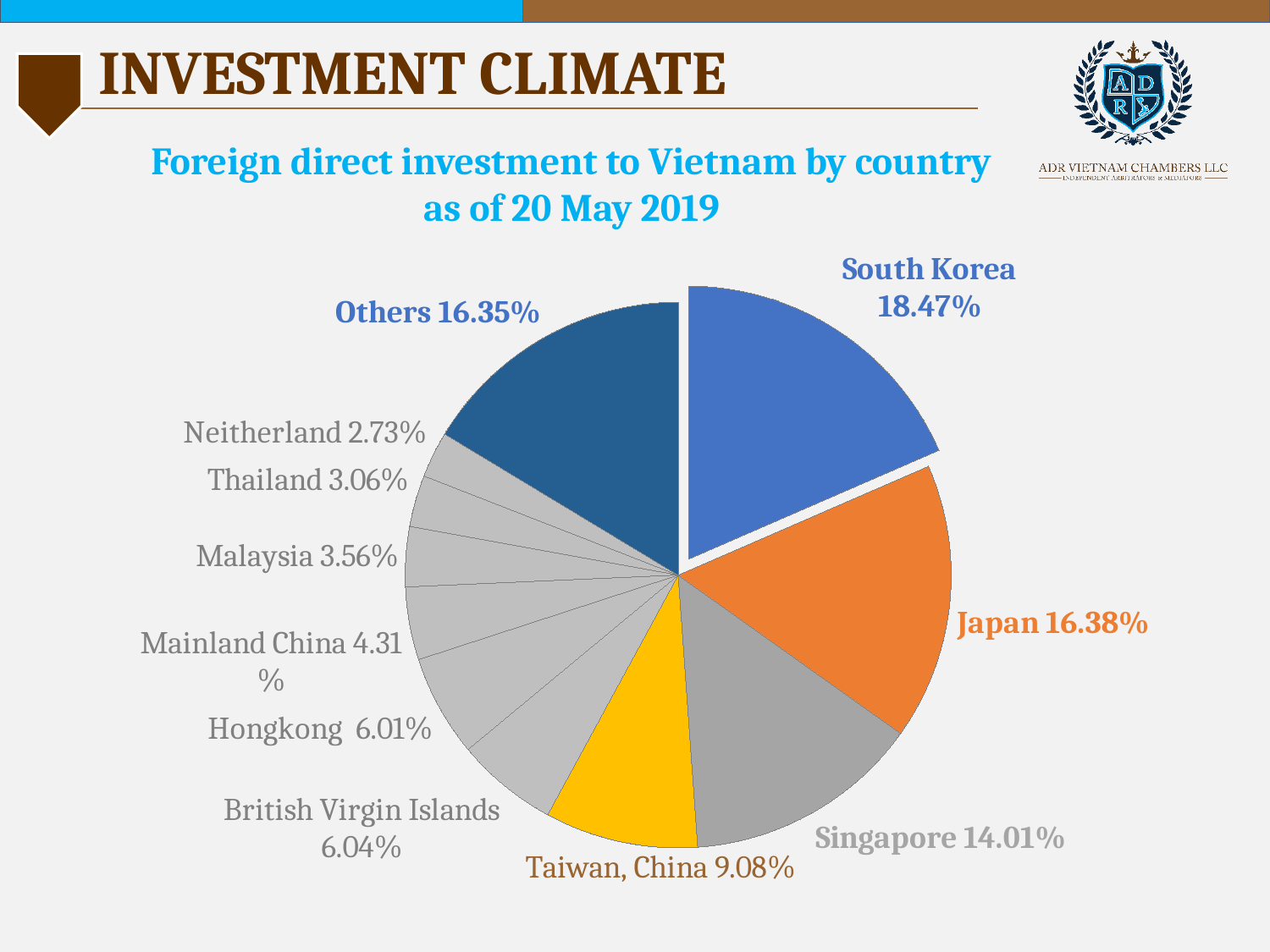
Which named country has the largest share of foreign direct investment to Vietnam? South Korea What percentage is shown for Malaysia? 3.56% What is the difference in percentage points between Singapore and Taiwan, China? 4.93 What share of foreign direct investment to Vietnam does South Korea account for? 18.47% Which slice of the pie chart has the smallest share? Neitherland What type of chart is shown on the slide? Pie chart What percentage is shown for Singapore? 14.01% What is the value shown for Japan in the pie chart? 16.38% How many slices does the pie chart have? 11 How many percentage points larger is South Korea's share than Japan's? 2.09 What share is labelled for Taiwan, China? 9.08% Which has a larger share, Singapore or Taiwan, China? Singapore